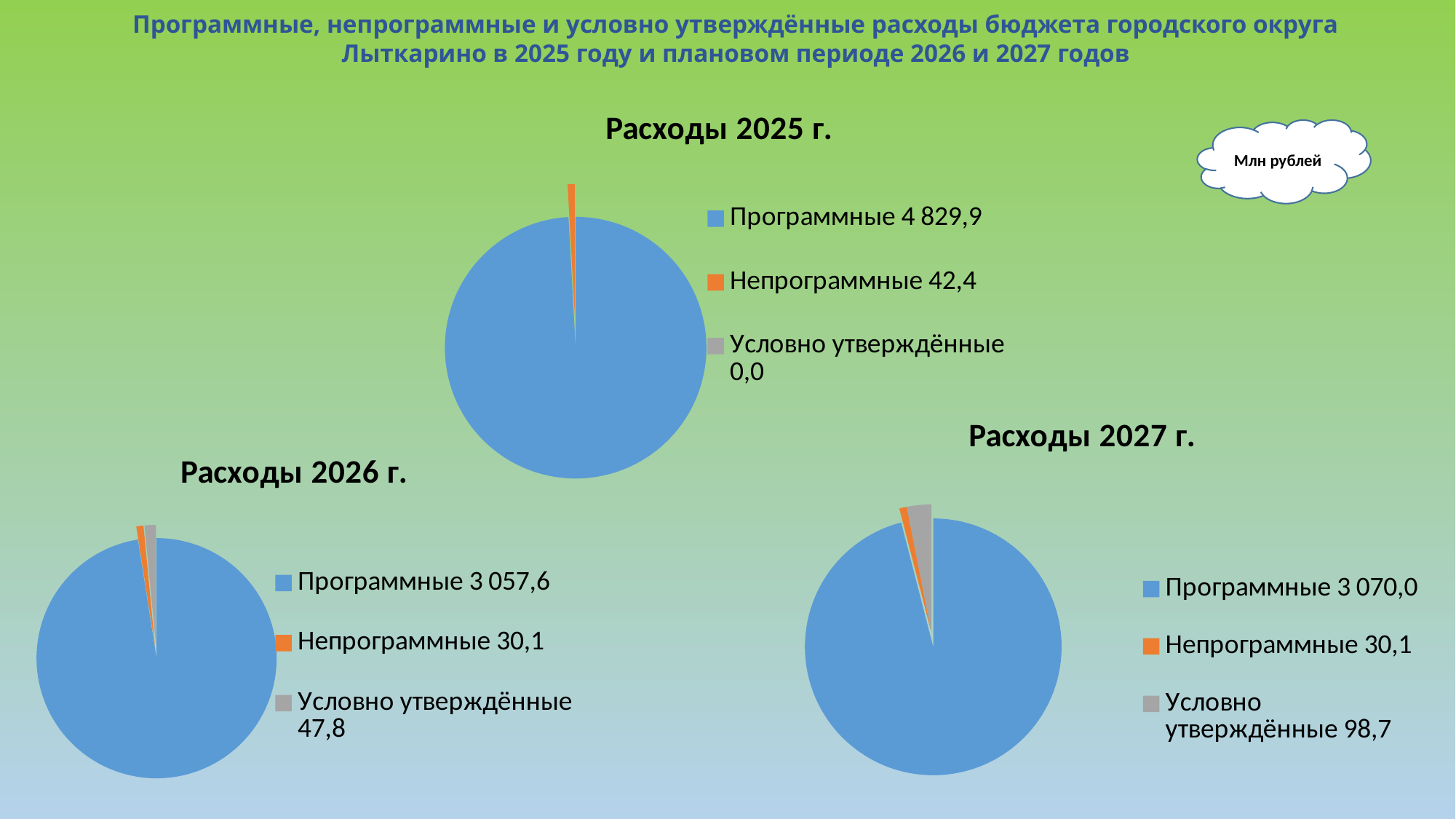
How many categories does the chart titled «Расходы 2025 г.» show in its legend? 3 On the chart titled «Расходы 2027 г.», which category has the largest value? Программные On the chart titled «Расходы 2026 г.», which is larger: Условно утверждённые or Непрограммные? Условно утверждённые On the chart titled «Расходы 2026 г.», which category has the smallest value? Непрограммные On the chart titled «Расходы 2025 г.», what is the value for Непрограммные? 42,4 On the chart titled «Расходы 2027 г.», what is the value for Условно утверждённые? 98,7 On the chart titled «Расходы 2025 г.», what is the total of all three categories? 4 872,3 On the chart titled «Расходы 2027 г.», what is the difference between Условно утверждённые and Непрограммные? 68,6 What kind of chart is «Расходы 2026 г.»? Pie chart What unit of measurement is indicated in the cloud shape on the slide? Млн рублей On the chart titled «Расходы 2025 г.», what is the value for Программные? 4 829,9 On the chart titled «Расходы 2026 г.», what is the value for Условно утверждённые? 47,8